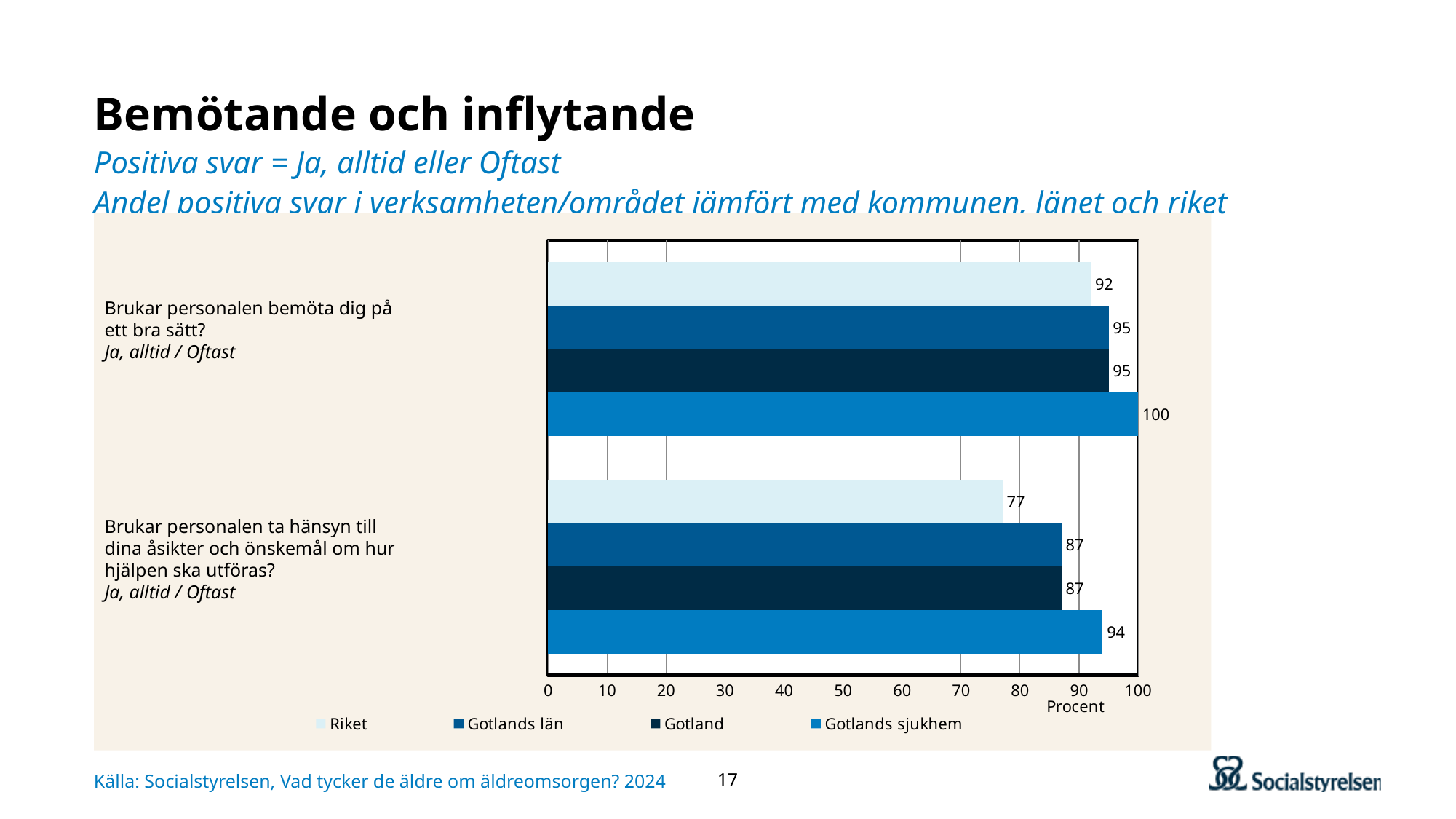
Which series has the lowest value for the question "Brukar personalen bemöta dig på ett bra sätt?"? Riket What is the value for Gotlands län for the question "Brukar personalen ta hänsyn till dina åsikter och önskemål om hur hjälpen ska utföras?"? 87 What is the value for Riket for the question "Brukar personalen ta hänsyn till dina åsikter och önskemål om hur hjälpen ska utföras?"? 77 What kind of chart is shown on the slide? Bar chart Which series has the highest value for the question "Brukar personalen ta hänsyn till dina åsikter och önskemål om hur hjälpen ska utföras?"? Gotlands sjukhem What is the difference between Gotlands sjukhem and Riket for the question "Brukar personalen ta hänsyn till dina åsikter och önskemål om hur hjälpen ska utföras?"? 17 What is the label of the x axis? Procent Which is larger for Riket: the value for "Brukar personalen bemöta dig på ett bra sätt?" or for "Brukar personalen ta hänsyn till dina åsikter och önskemål om hur hjälpen ska utföras?"? Brukar personalen bemöta dig på ett bra sätt? What is the value for Gotlands sjukhem for the question "Brukar personalen bemöta dig på ett bra sätt?"? 100 How many series does the legend list? 4 How many question categories are shown on the chart? 2 What is the value for Gotland for the question "Brukar personalen bemöta dig på ett bra sätt?"? 95